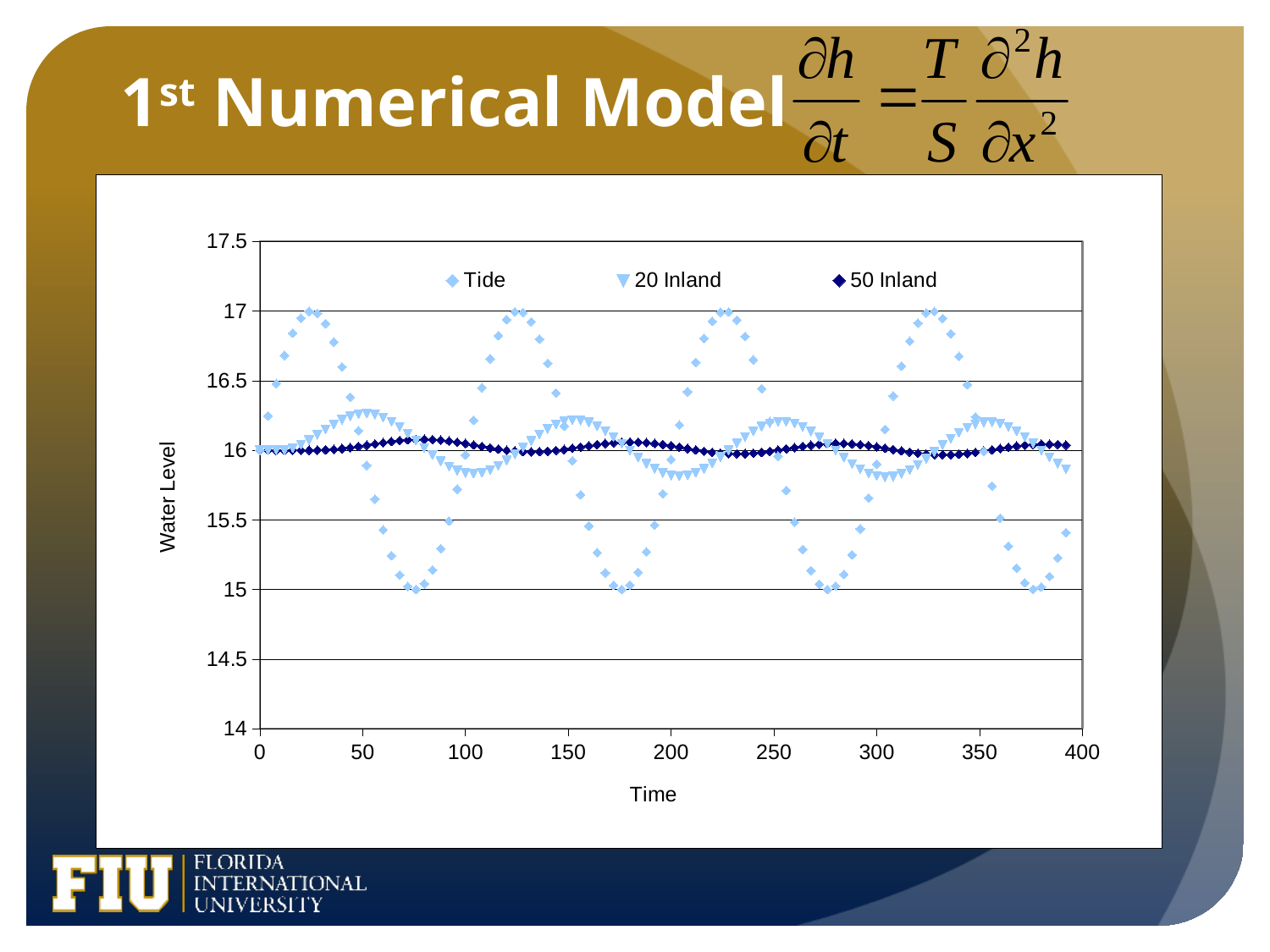
What is the label of the vertical axis? Water Level How many peaks does the Tide series reach at a water level of 17 across the plotted time range? 4 Is the 50 Inland value at time 100 greater or less than 16.5? less Is the Tide value at time 75 greater or less than 15.5? less Is the Tide value at time 25 greater or less than 16.5? greater What are the three series named in the legend? Tide, 20 Inland, 50 Inland How many series does the legend list? 3 What is the lowest water level reached by the Tide series? 15 What is the highest water level reached by the Tide series? 17 Which series shows the largest swings in water level? Tide What kind of chart is shown on the slide? Scatter chart